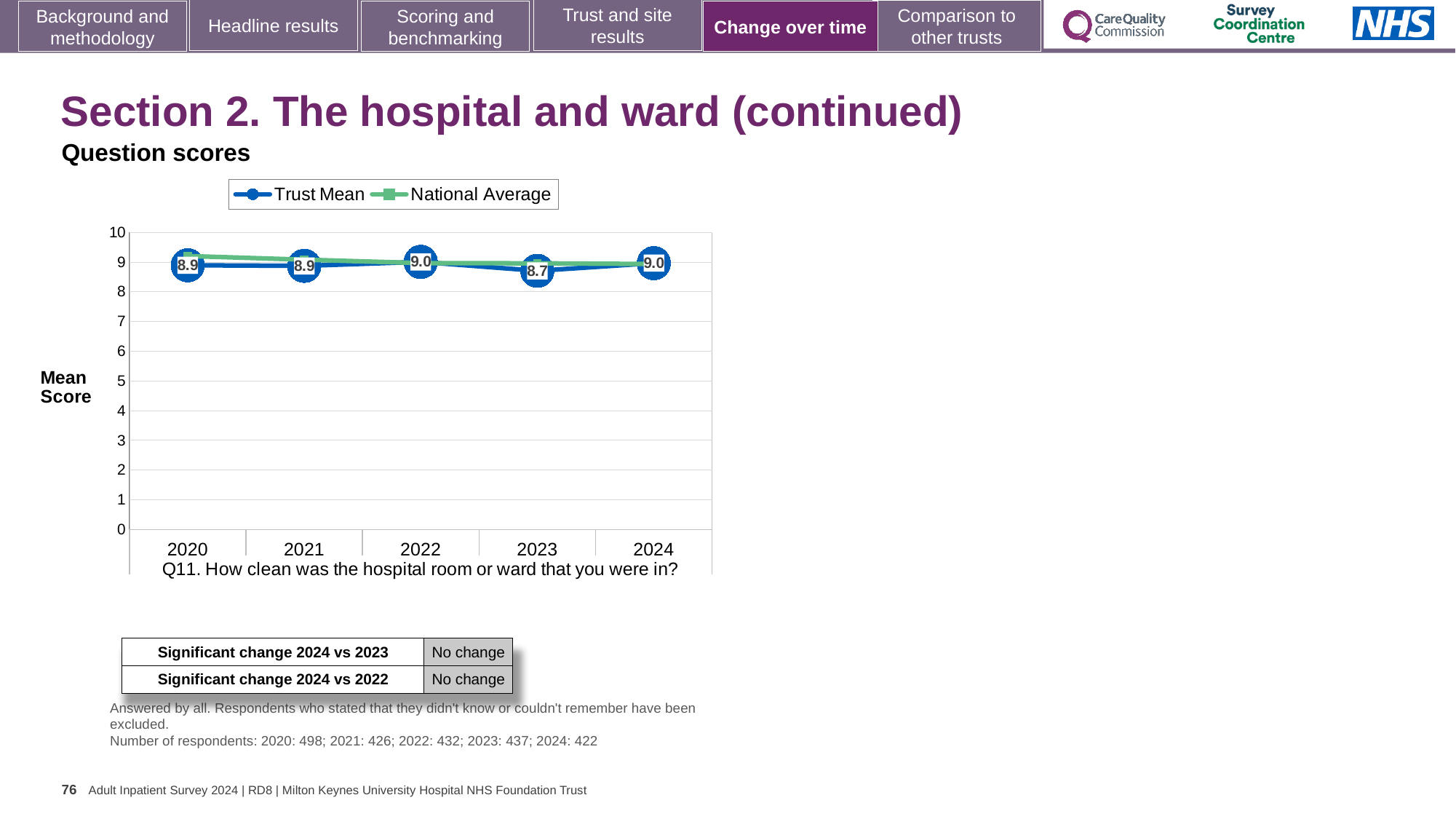
What is the Trust Mean value for 2020? 8.9 How many series does the legend list? 2 What is the Trust Mean value for 2024? 9.0 Does the Trust Mean rise or fall from 2023 to 2024? rise What kind of chart is shown on the slide? line chart How many years are shown on the x axis of the chart? 5 Which year has the larger Trust Mean, 2022 or 2023? 2022 What is the difference between the Trust Mean in 2024 and in 2023? 0.3 What is the Trust Mean value for 2023? 8.7 Is the National Average value for 2020 greater or less than 8? greater In which year is the Trust Mean lowest? 2023 Which survey question does the chart relate to, as labelled below the x axis? Q11. How clean was the hospital room or ward that you were in?